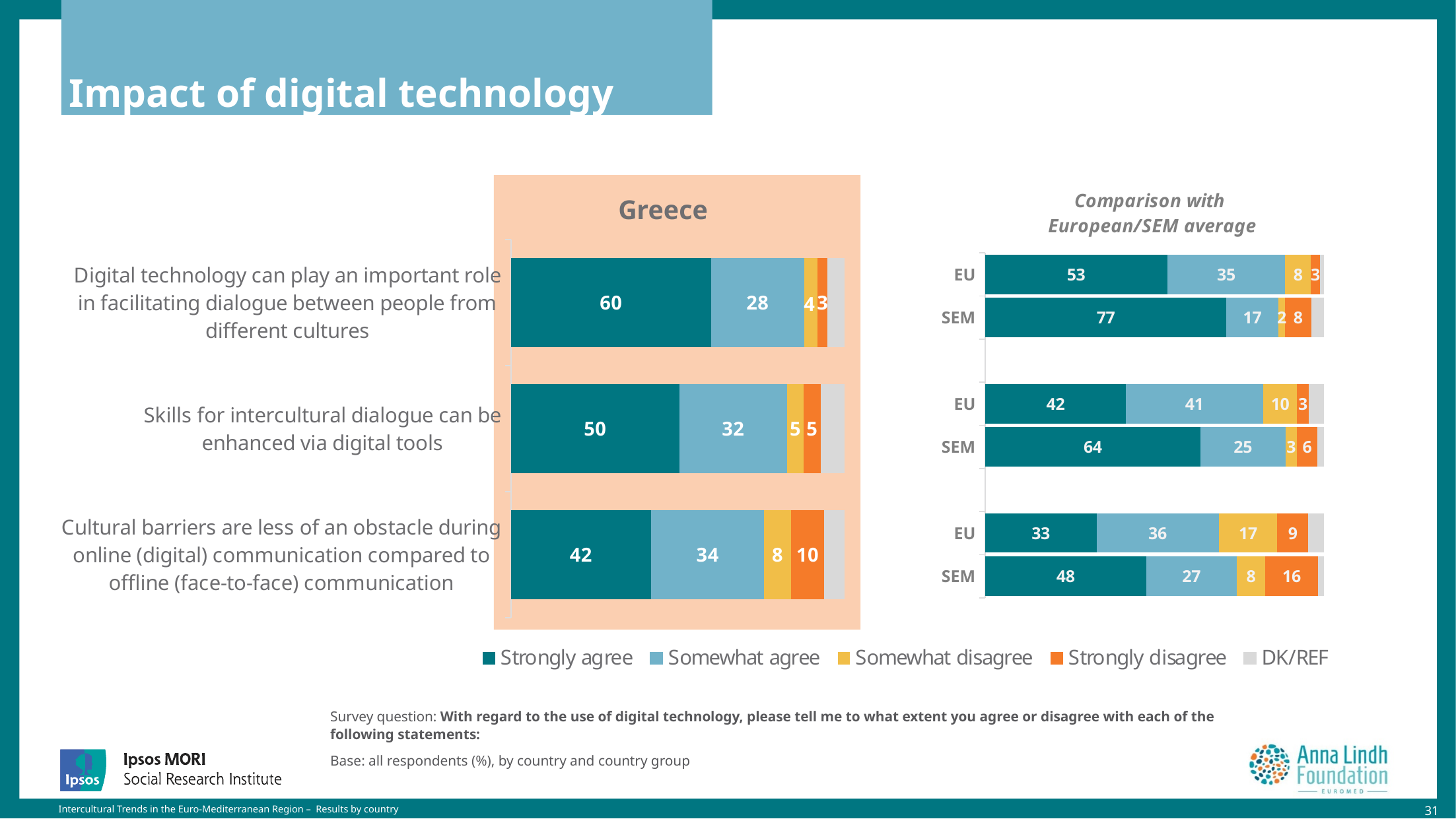
In the 'Comparison with European/SEM average' chart, for the second statement, which has the larger 'Strongly agree' value, EU or SEM? SEM In the Greece chart, how many statements are plotted? 3 In the 'Comparison with European/SEM average' chart, what is the difference between the SEM (48) and EU (33) 'Strongly agree' values for the third statement? 15 In the Greece chart, what is the difference between the 'Strongly agree' values for the first statement (60) and the third statement (42)? 18 In the Greece chart, which statement has the highest 'Strongly agree' value? Digital technology can play an important role in facilitating dialogue between people from different cultures In the 'Comparison with European/SEM average' chart, what is the EU 'Somewhat disagree' value for the third statement? 17 What kind of chart is the Greece chart? Stacked bar chart In the Greece chart, what is the 'Somewhat agree' value for 'Skills for intercultural dialogue can be enhanced via digital tools'? 32 In the 'Comparison with European/SEM average' chart, what is the SEM 'Strongly agree' value for the first statement? 77 In the Greece chart, what is the 'Strongly disagree' value for 'Cultural barriers are less of an obstacle during online (digital) communication compared to offline (face-to-face) communication'? 10 In the Greece chart, what percentage strongly agree that digital technology can play an important role in facilitating dialogue between people from different cultures? 60 How many series does the legend list? 5